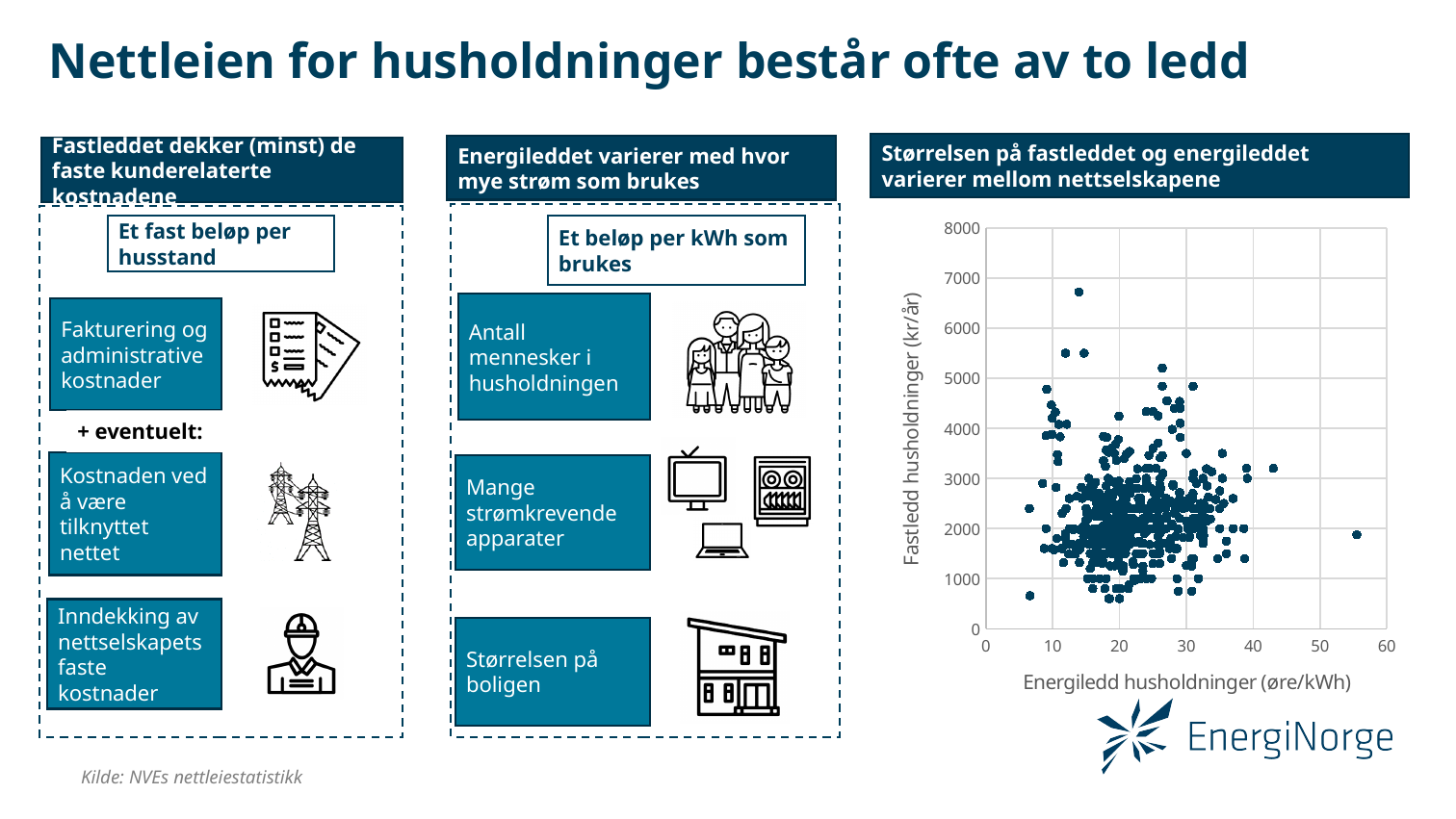
In the chart on the right, what is the label of the vertical axis? Fastledd husholdninger (kr/år) In the chart on the right, is the Fastledd value of the rightmost plotted point greater or less than 3000? less In the chart on the right, is the highest plotted point's Fastledd value greater or less than 6000? greater What kind of chart is shown on the right side of the slide? scatter chart In the chart on the right, is the Fastledd value of the highest plotted point greater or less than 7000? less What is the title of the chart on the right side of the slide? Størrelsen på fastleddet og energileddet varierer mellom nettselskapene